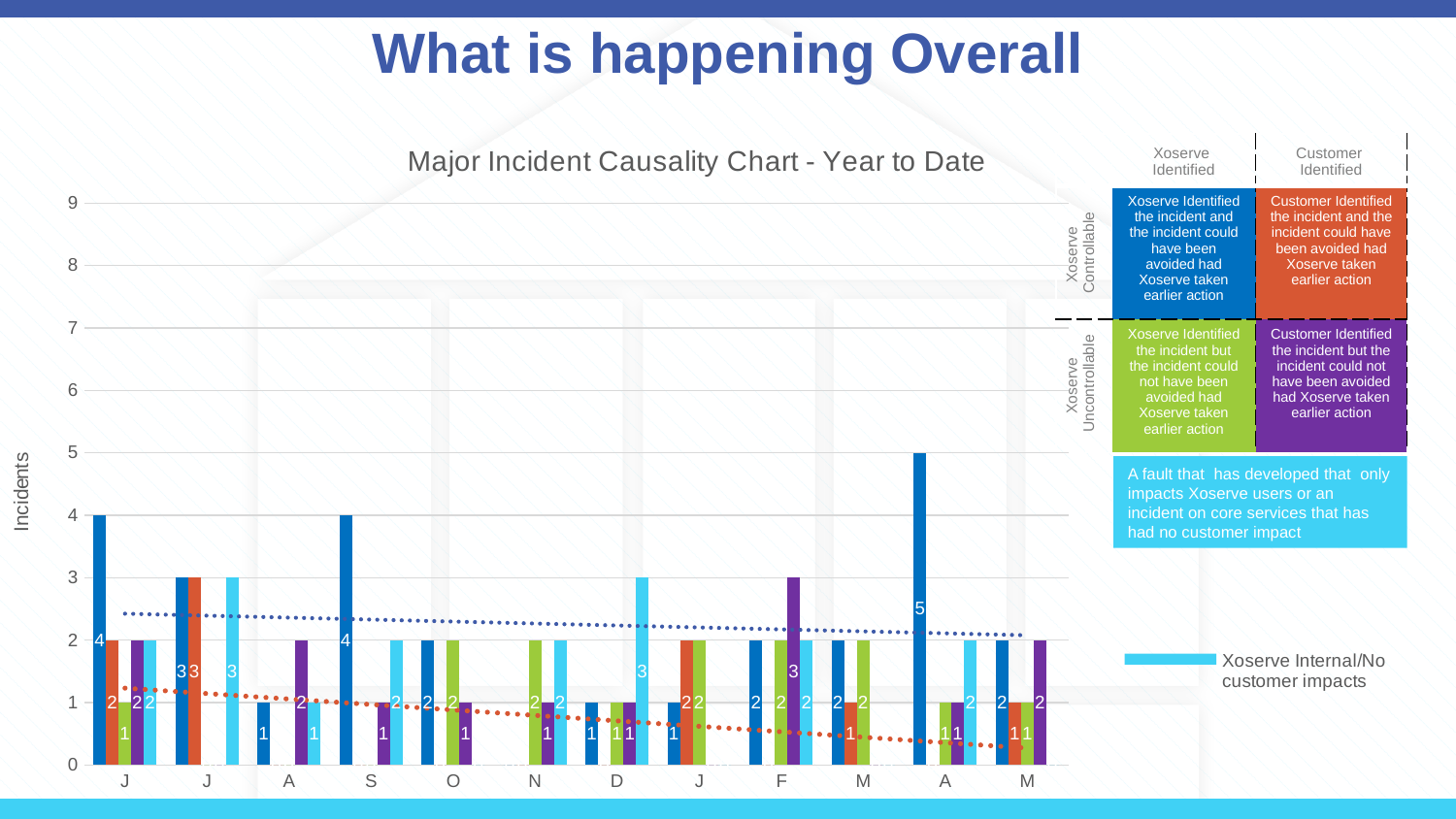
Which is larger: the dark blue bar for the first J month or the dark blue bar for the second A month? the second A month What is the value of the dark blue bar for the first J month (leftmost category)? 4 Is the value of the dark blue bar for the second A month greater or less than 4? greater What is the label on the vertical axis of the chart? Incidents What is the value of the light blue bar for the D month? 3 What is the highest value labelled on any bar in the chart? 5 What is the value of the orange bar for the second J month? 3 How many month categories are shown along the x axis of the chart? 12 What is the difference between the dark blue bar for the second A month and the dark blue bar for the first J month? 1 What is the title of the chart on the slide? Major Incident Causality Chart - Year to Date What type of chart is the Major Incident Causality Chart? bar chart What is the value of the purple bar for the F month? 3